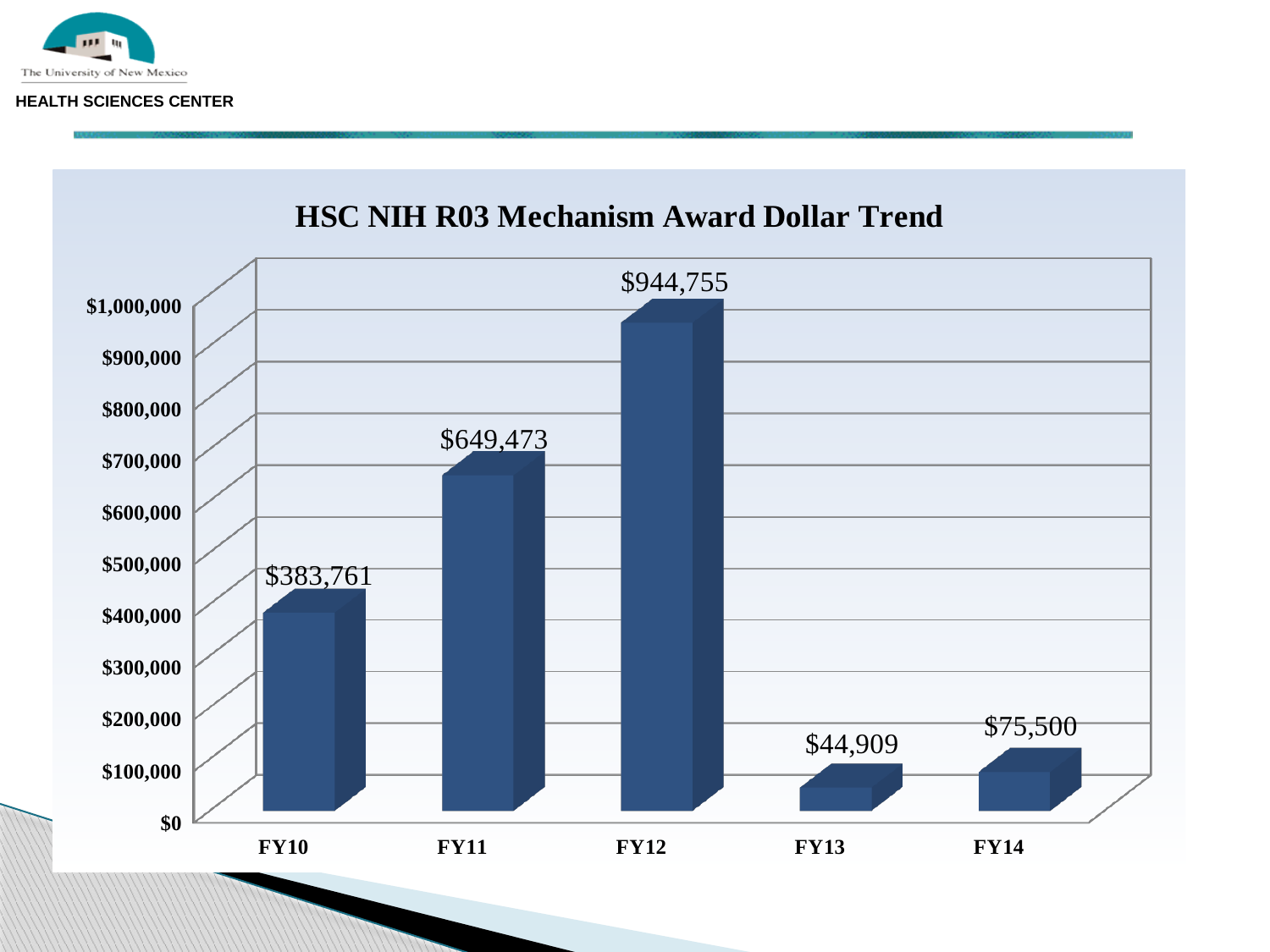
What is the award dollar value for FY13? $44,909 What is the title of the chart? HSC NIH R03 Mechanism Award Dollar Trend Which is larger, the award dollar value for FY10 or FY11? FY11 What is the award dollar value for FY10? $383,761 Is the value for FY11 greater or less than $600,000? greater What kind of chart is shown on the slide? bar chart What is the difference between the FY14 and FY13 award dollar values? $30,591 What is the difference between the FY12 and FY11 award dollar values? $295,282 Which fiscal year has the highest award dollar value? FY12 Which fiscal year has the lowest award dollar value? FY13 What is the award dollar value for FY12? $944,755 How many fiscal years are shown on the chart? 5